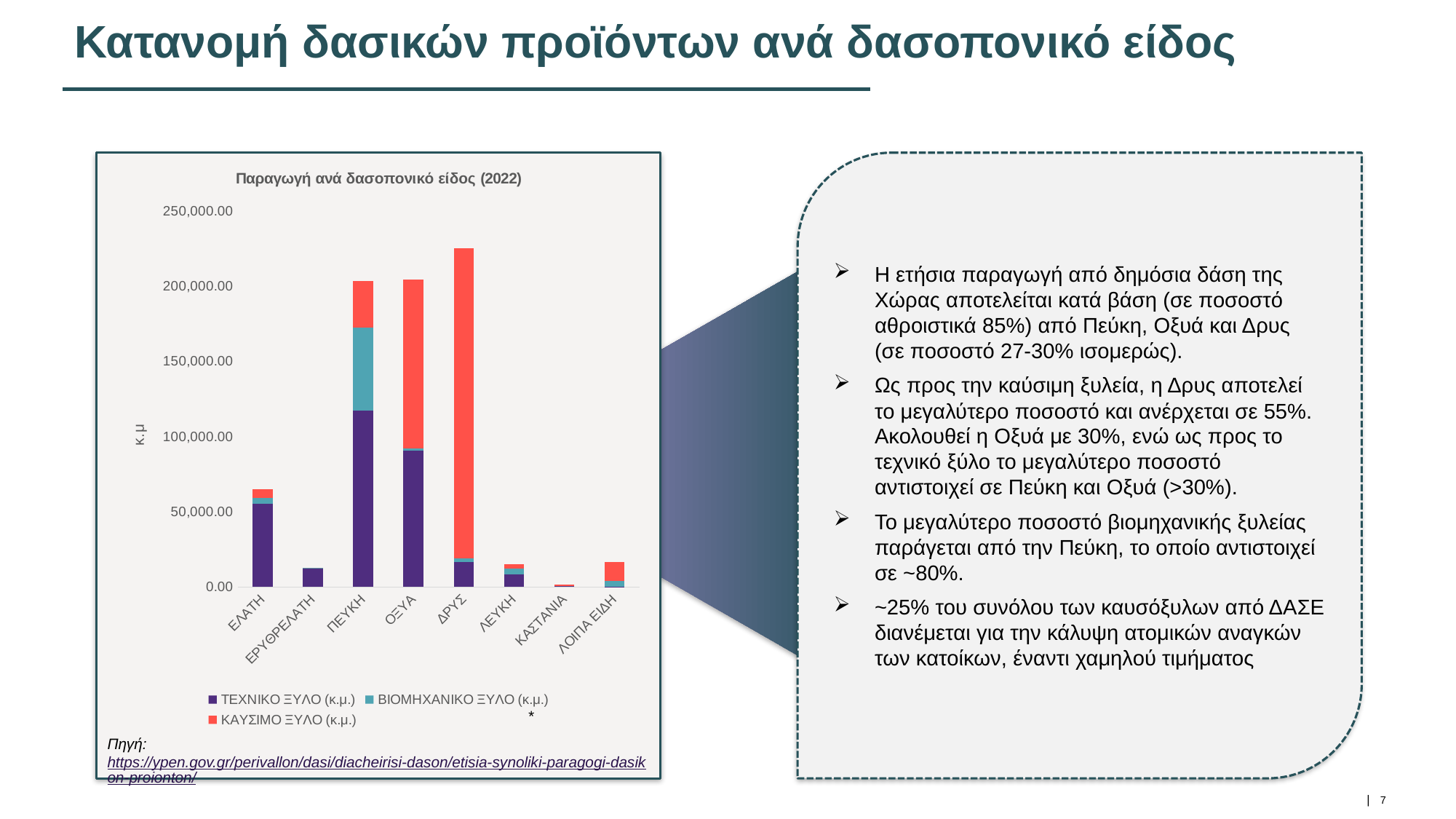
Which category has the largest ΒΙΟΜΗΧΑΝΙΚΟ ΞΥΛΟ (κ.μ.) segment? ΠΕΥΚΗ How many tree species categories are shown on the x axis? 8 What is the title of the chart? Παραγωγή ανά δασοπονικό είδος (2022) Is the ΤΕΧΝΙΚΟ ΞΥΛΟ (κ.μ.) value for ΠΕΥΚΗ greater or less than 100,000.00? greater Which category has the lowest total bar? ΚΑΣΤΑΝΙΑ What kind of chart is shown on the slide? Stacked bar chart How many series does the chart legend list? 3 Is the total value for ΕΡΥΘΡΕΛΑΤΗ greater or less than 50,000.00? less Is the total value for ΔΡΥΣ greater or less than 200,000.00? greater What is the label of the y axis? κ.μ. Which has the larger total bar, ΔΡΥΣ or ΠΕΥΚΗ? ΔΡΥΣ Which category has the highest total bar? ΔΡΥΣ